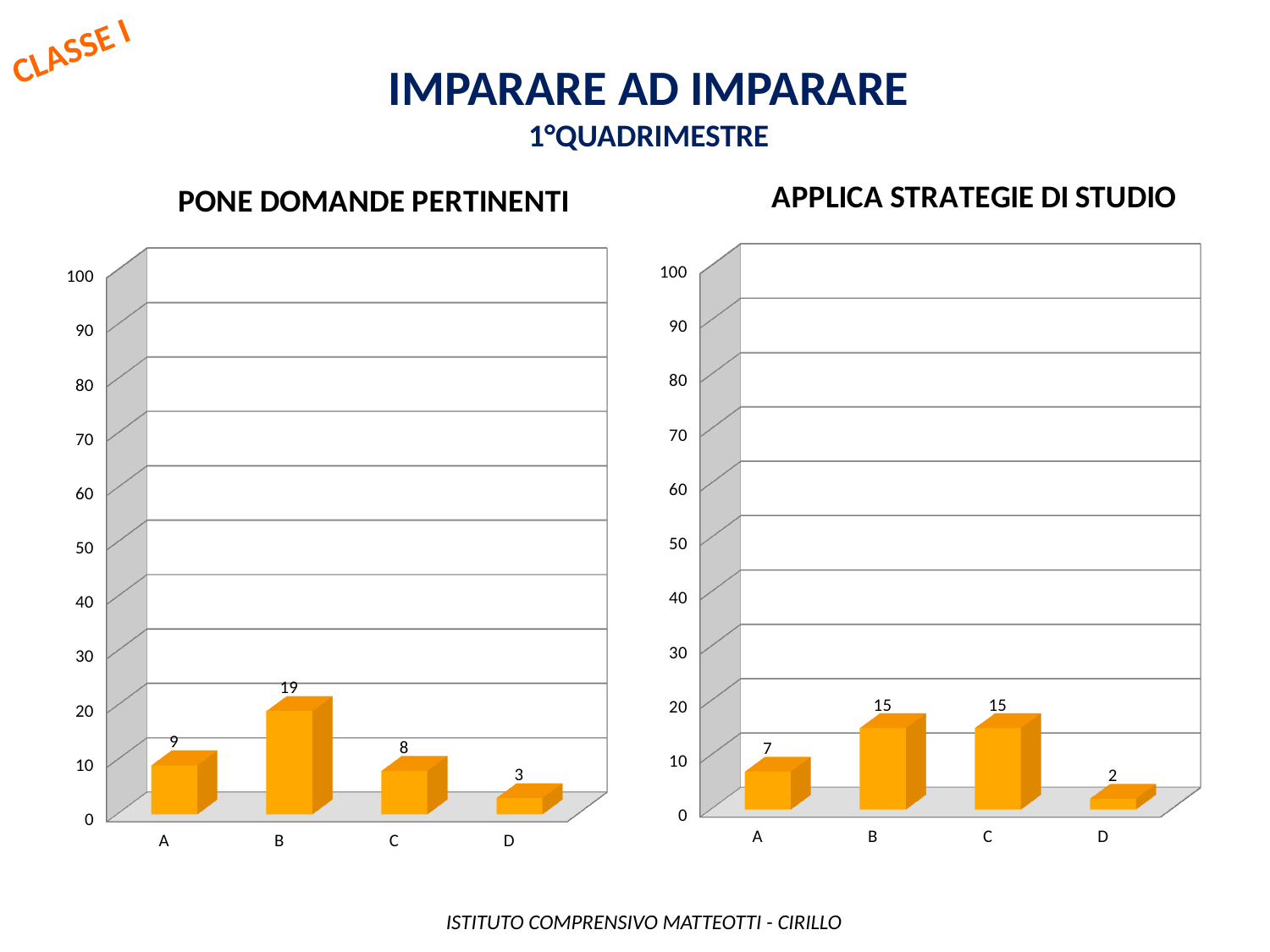
In the 'PONE DOMANDE PERTINENTI' chart, what is the difference between the values for B and D? 16 In the 'PONE DOMANDE PERTINENTI' chart, which is larger, the value for A or the value for C? A What kind of chart is the 'APPLICA STRATEGIE DI STUDIO' chart? bar chart What is the title of the chart on the left side of the slide? PONE DOMANDE PERTINENTI In the 'APPLICA STRATEGIE DI STUDIO' chart, what is the value for category A? 7 In the 'PONE DOMANDE PERTINENTI' chart, which category has the highest value? B In the 'APPLICA STRATEGIE DI STUDIO' chart, which category has the lowest value? D How many categories are shown in the 'PONE DOMANDE PERTINENTI' chart? 4 In the 'APPLICA STRATEGIE DI STUDIO' chart, is the value for C greater or less than 10? greater In the 'PONE DOMANDE PERTINENTI' chart, what is the value for category B? 19 In the 'APPLICA STRATEGIE DI STUDIO' chart, what is the difference between the values for B and A? 8 In the 'APPLICA STRATEGIE DI STUDIO' chart, what is the value for category D? 2